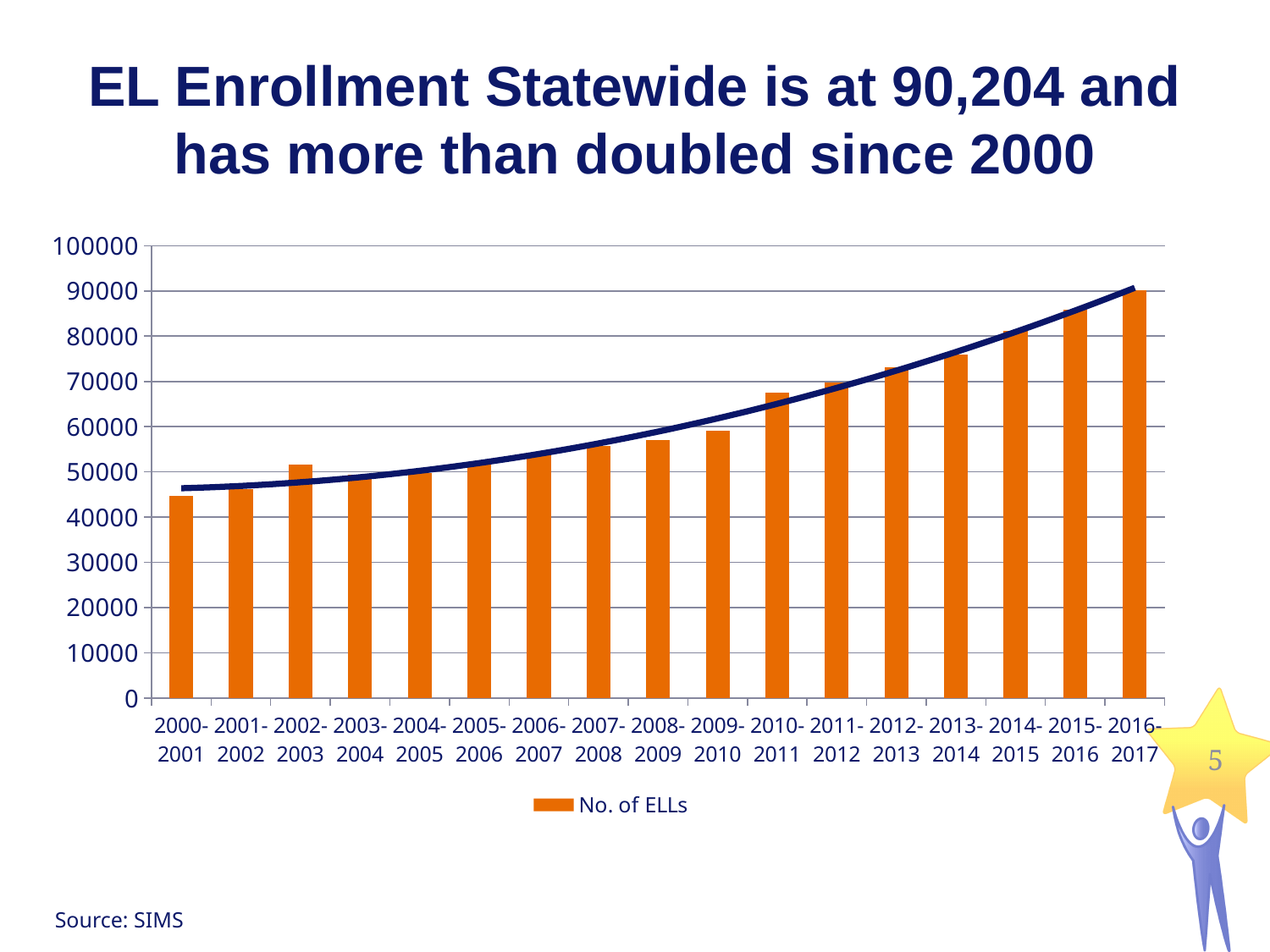
Which school year has the highest number of ELLs? 2016-2017 How many school-year categories are shown on the x axis? 17 Is the value for 2013-2014 greater or less than 70000? greater Is the value for 2016-2017 greater or less than 80000? greater Do the values generally rise or fall from 2000-2001 to 2016-2017? rise What is the name of the series shown in the legend? No. of ELLs Is the value for 2000-2001 greater or less than 50000? less Which school year has the lowest number of ELLs? 2000-2001 How many series does the legend list? 1 What kind of chart is shown on the slide? bar chart Which is larger, the value for 2002-2003 or the value for 2003-2004? 2002-2003